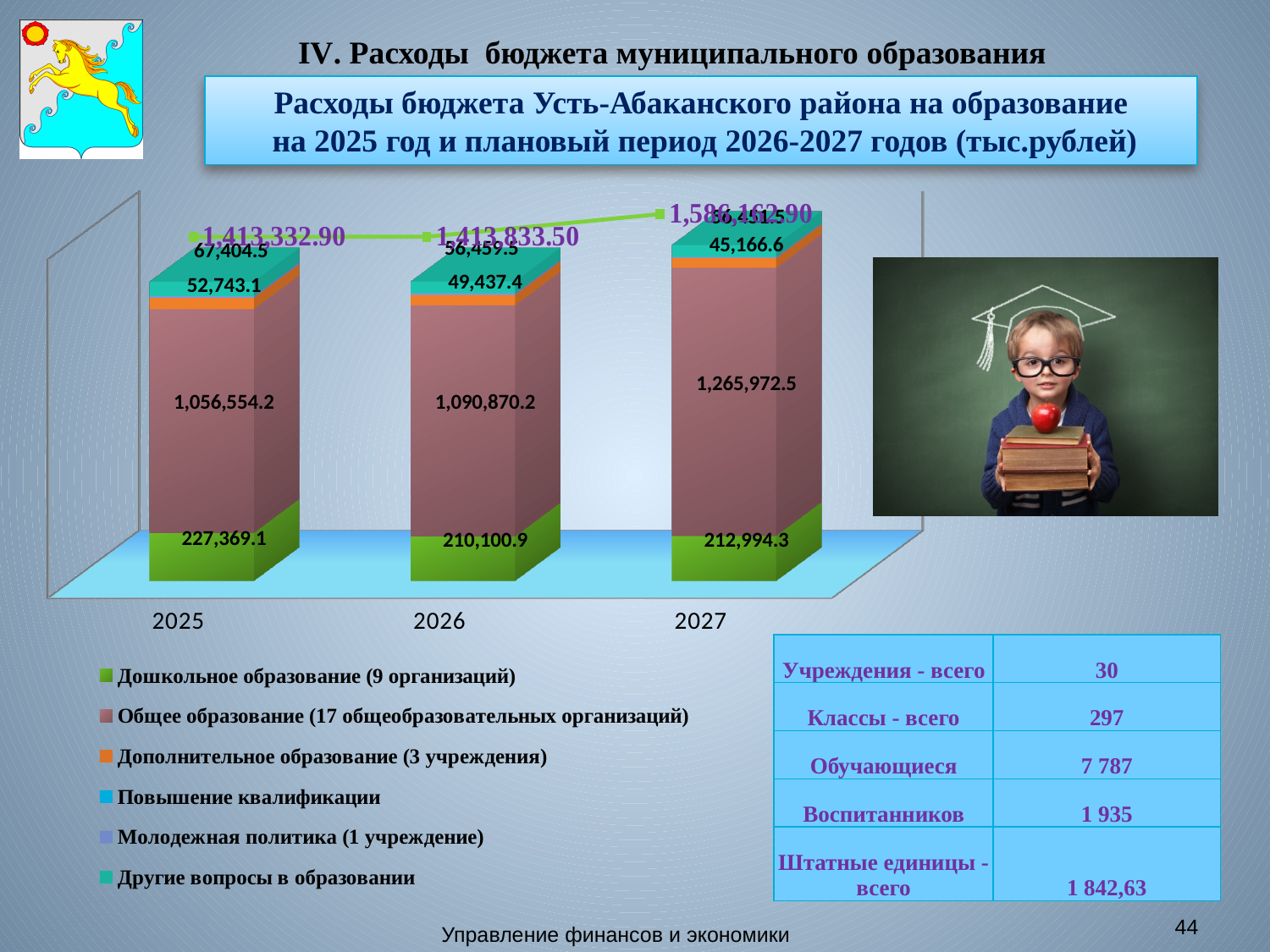
What is the value for Дошкольное образование in 2025? 227,369.1 What is the value for Общее образование in 2027? 1,265,972.5 What is the value for Дошкольное образование in 2026? 210,100.9 In which year is the value for Дошкольное образование the lowest? 2026 What is the difference between the Общее образование values for 2027 and 2025? 209,418.3 How many series does the chart legend list? 6 Which is larger: the Дошкольное образование value for 2025 or for 2027? 2025 What is the value for Общее образование in 2025? 1,056,554.2 Does the value for Общее образование rise or fall from 2025 to 2027? Rises What kind of chart is shown on the slide? Stacked bar chart In which year is the value for Общее образование the highest? 2027 How many years (categories) are shown on the x axis of the chart? 3